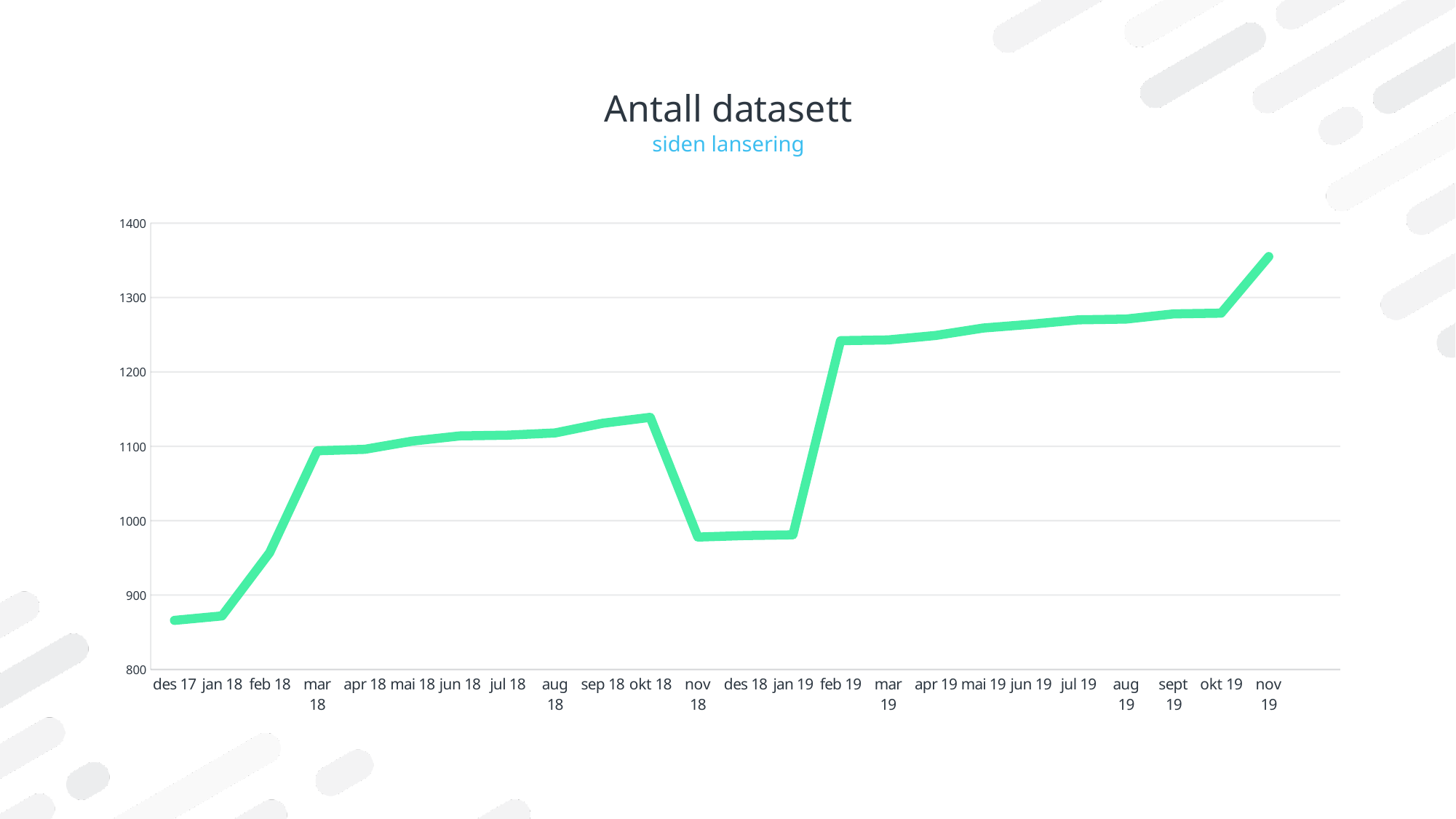
Is the value for des 17 greater or less than 900? less Is the value for nov 18 greater or less than 1000? less Do the values rise or fall from feb 19 to nov 19? rise How many months (data points) are plotted along the x axis? 24 Which is larger, the value for okt 18 or the value for nov 18? okt 18 Is the value for okt 18 greater or less than 1100? greater What is the subtitle shown under the chart title? siden lansering Which month has the lowest value? des 17 What is the title of the chart? Antall datasett What kind of chart is shown on the slide? line chart Which month has the highest value? nov 19